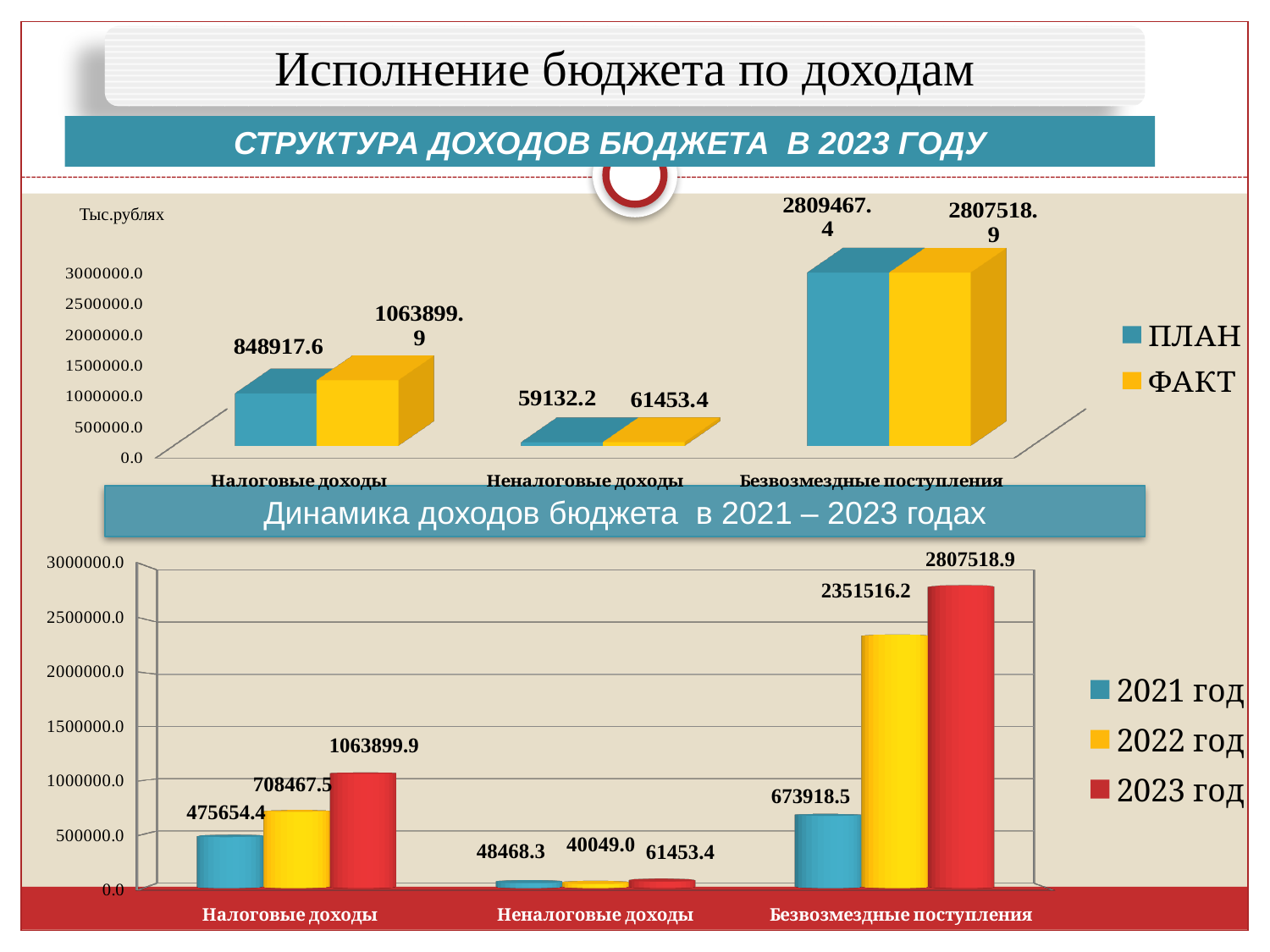
In the bottom chart (Динамика доходов бюджета в 2021 – 2023 годах), how many categories are shown on the x axis? 3 In the top chart (СТРУКТУРА ДОХОДОВ БЮДЖЕТА В 2023 ГОДУ), what is the ПЛАН value for Налоговые доходы? 848917.6 In the top chart (СТРУКТУРА ДОХОДОВ БЮДЖЕТА В 2023 ГОДУ), how many series does the legend list? 2 In the bottom chart (Динамика доходов бюджета в 2021 – 2023 годах), which is larger: Безвозмездные поступления in 2021 год or Налоговые доходы in 2022 год? Налоговые доходы in 2022 год In the bottom chart (Динамика доходов бюджета в 2021 – 2023 годах), what is the value for Безвозмездные поступления in 2022 год? 2351516.2 In the top chart (СТРУКТУРА ДОХОДОВ БЮДЖЕТА В 2023 ГОДУ), which category has the highest ФАКТ value? Безвозмездные поступления In the top chart (СТРУКТУРА ДОХОДОВ БЮДЖЕТА В 2023 ГОДУ), what is the ФАКТ value for Неналоговые доходы? 61453.4 In the bottom chart (Динамика доходов бюджета в 2021 – 2023 годах), which year has the lowest value for Неналоговые доходы? 2022 год In the bottom chart (Динамика доходов бюджета в 2021 – 2023 годах), what is the value for Неналоговые доходы in 2021 год? 48468.3 In the top chart (СТРУКТУРА ДОХОДОВ БЮДЖЕТА В 2023 ГОДУ), what is the difference between the ФАКТ and ПЛАН values for Налоговые доходы? 214982.3 In the bottom chart (Динамика доходов бюджета в 2021 – 2023 годах), do the values for Налоговые доходы rise or fall from 2021 to 2023? rise What kind of chart is the bottom chart (Динамика доходов бюджета в 2021 – 2023 годах)? bar chart